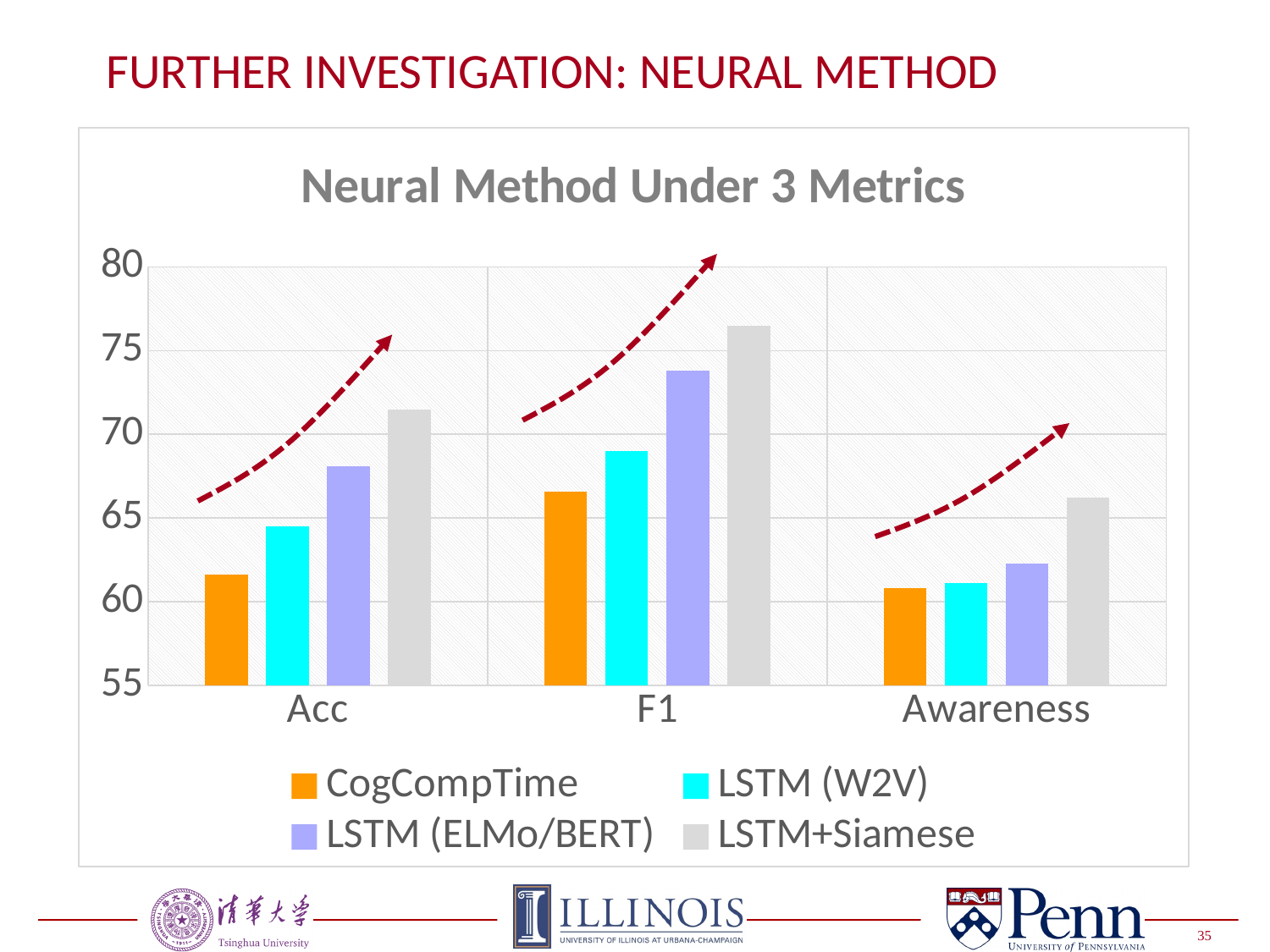
Which series has the highest value for F1? LSTM+Siamese Which series has the lowest value for Acc? CogCompTime Which is larger: the LSTM+Siamese value for F1 or the LSTM+Siamese value for Awareness? F1 How many metrics (categories) are shown on the x axis? 3 What is the title of the chart? Neural Method Under 3 Metrics How many series does the legend list? 4 What kind of chart is shown on the slide? bar chart Is the value of LSTM+Siamese for F1 greater or less than 75? greater Within each metric, do the bars rise or fall going from CogCompTime to LSTM+Siamese? rise Which series has the highest value for Acc? LSTM+Siamese Is the value of CogCompTime for Acc greater or less than 65? less Is the value of LSTM+Siamese for Acc greater or less than 70? greater